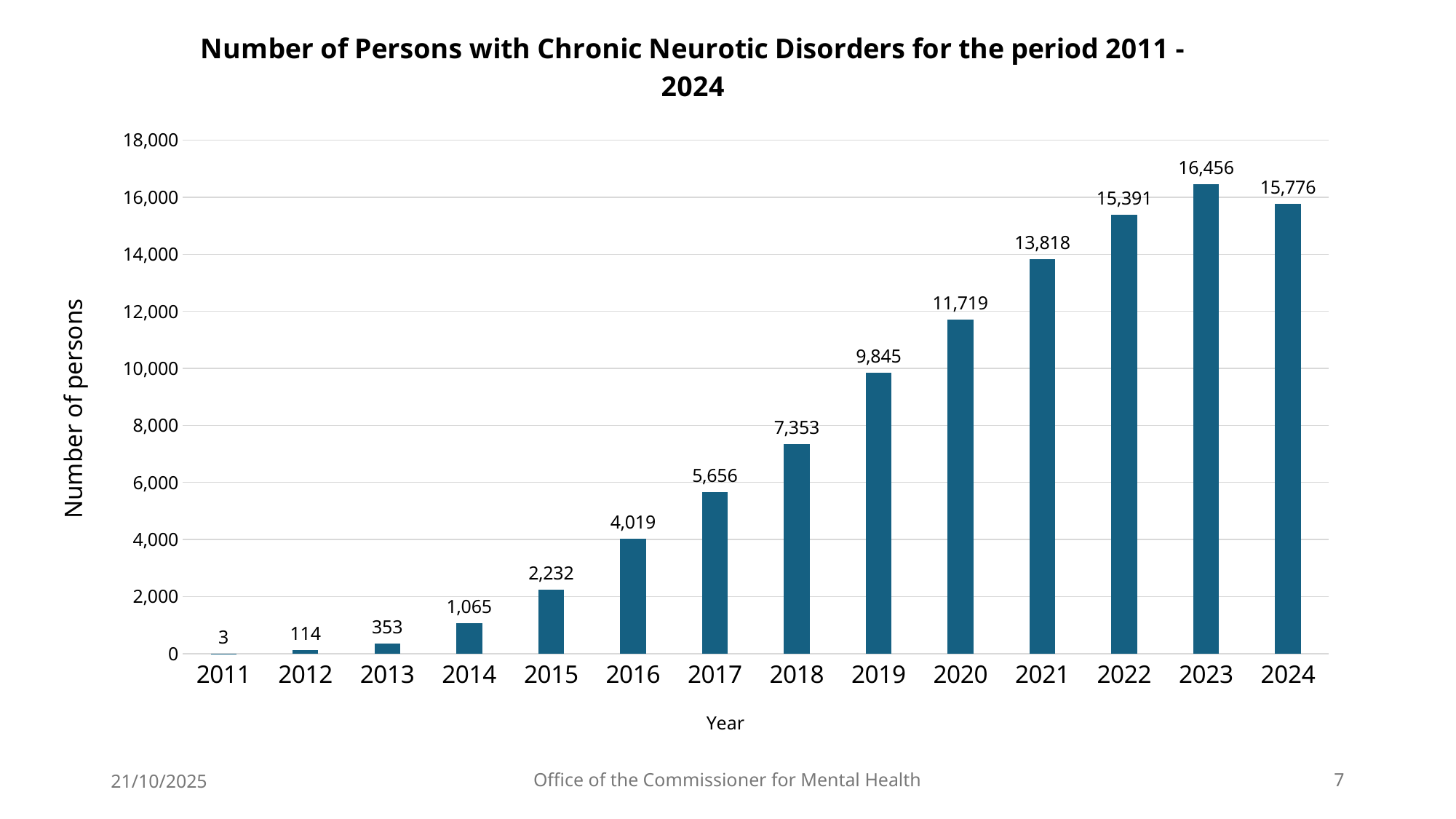
Which year has the lowest number of persons with chronic neurotic disorders? 2011 What is the number of persons with chronic neurotic disorders in 2024? 15,776 What is the difference between the number of persons in 2023 and in 2024? 680 Is the value for 2021 greater or less than 14,000? less What is the number of persons with chronic neurotic disorders in 2019? 9,845 How many years are shown on the x axis of the chart? 14 What is the label of the y axis? Number of persons What is the number of persons with chronic neurotic disorders in 2014? 1,065 Which year has a larger number of persons, 2017 or 2018? 2018 Which year has the highest number of persons with chronic neurotic disorders? 2023 What is the difference between the number of persons in 2020 and in 2019? 1,874 What kind of chart is shown on the slide? Bar chart